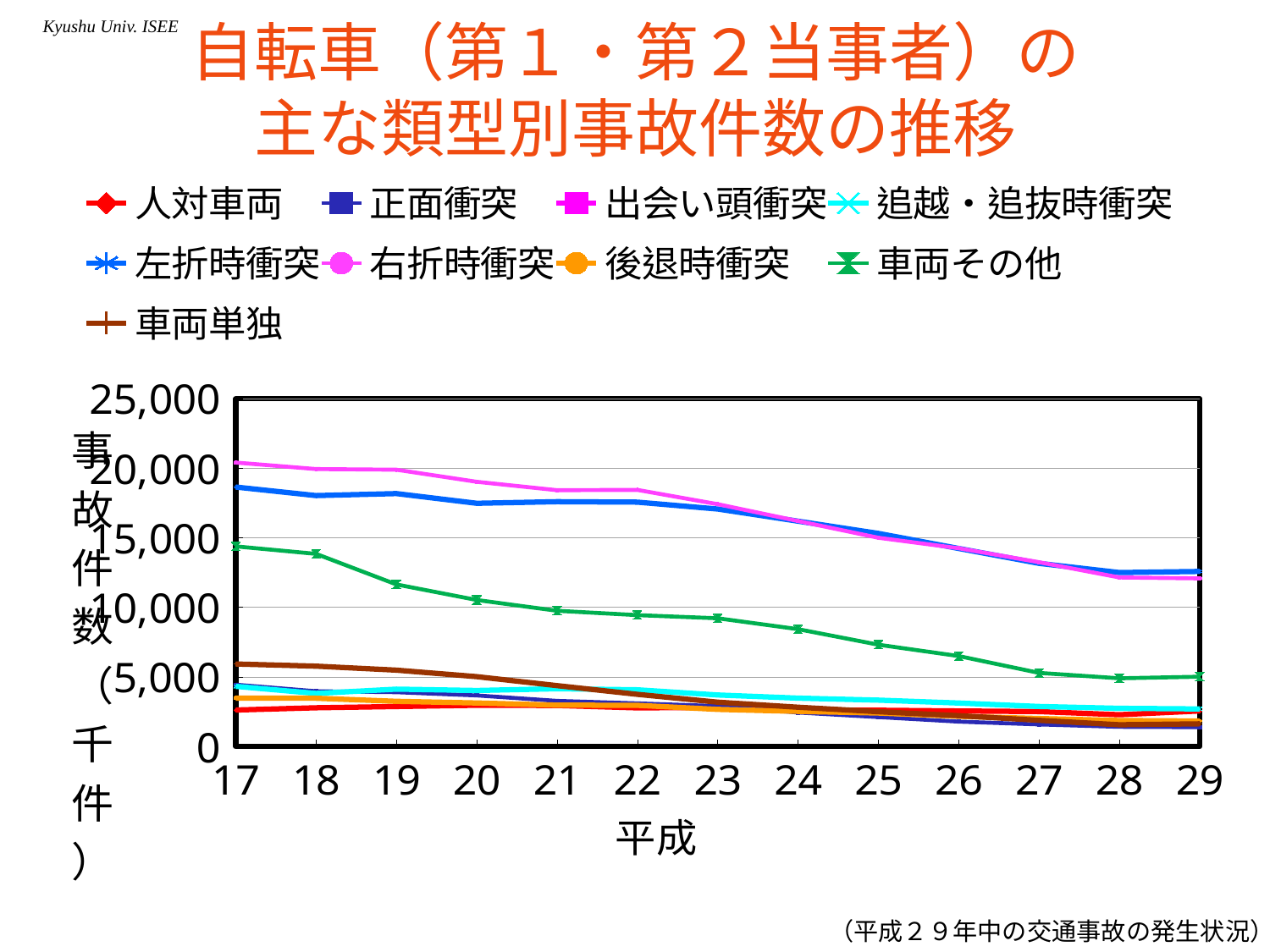
Is the value for 人対車両 in 平成17 greater or less than 5,000? less What is the label of the x axis? 平成 Is the value for 車両その他 in 平成17 greater or less than 10,000? greater Does the value for 車両単独 rise or fall from 平成17 to 平成29? fall How many years (points) are shown along the x axis? 13 In 平成29, which is larger: 車両その他 or 人対車両? 車両その他 In 平成17, which is larger: 車両その他 or 車両単独? 車両その他 What kind of chart is shown on the slide? line chart Does the value for 車両その他 rise or fall from 平成17 to 平成29? fall Is the value for 車両その他 in 平成29 greater or less than 10,000? less How many series does the legend list? 9